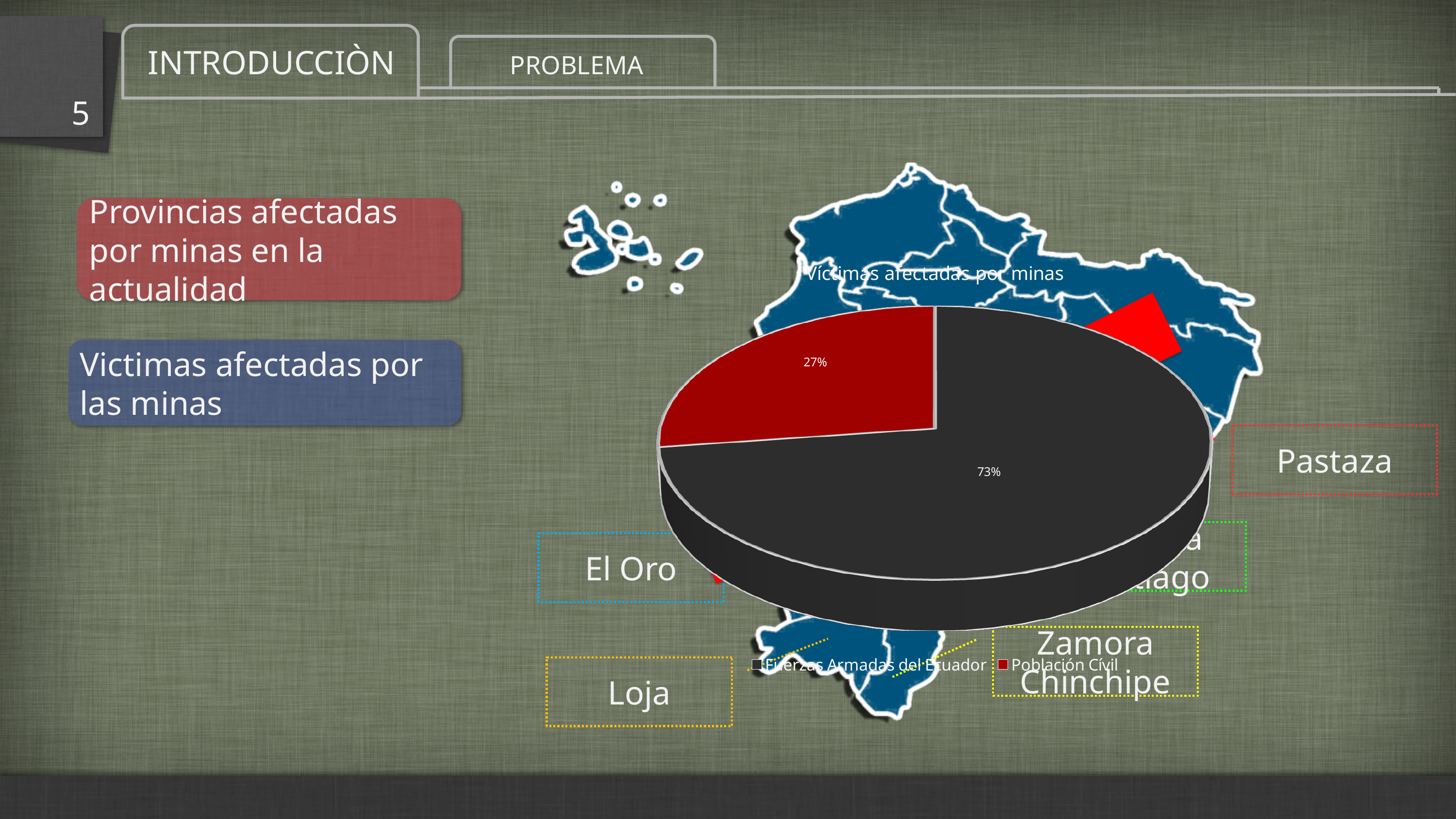
What kind of chart is shown on the slide? pie chart What is the title of the pie chart? Víctimas afectadas por minas Which is larger in the pie chart, the share for Población Civil or the share for Fuerzas Armadas del Ecuador? Fuerzas Armadas del Ecuador What percentage of the pie chart corresponds to Fuerzas Armadas del Ecuador? 73% How many entries does the legend of the pie chart list? 2 Which category has the largest share of the pie chart? Fuerzas Armadas del Ecuador How many slices does the pie chart have? 2 What is the difference in percentage points between the Fuerzas Armadas del Ecuador slice and the Población Civil slice? 46 Which category has the smallest share of the pie chart? Población Civil What is the share of the pie taken by the Población Civil slice? 27% What percentage of the pie chart corresponds to Población Civil? 27% What colour is the Población Civil slice in the pie chart? red